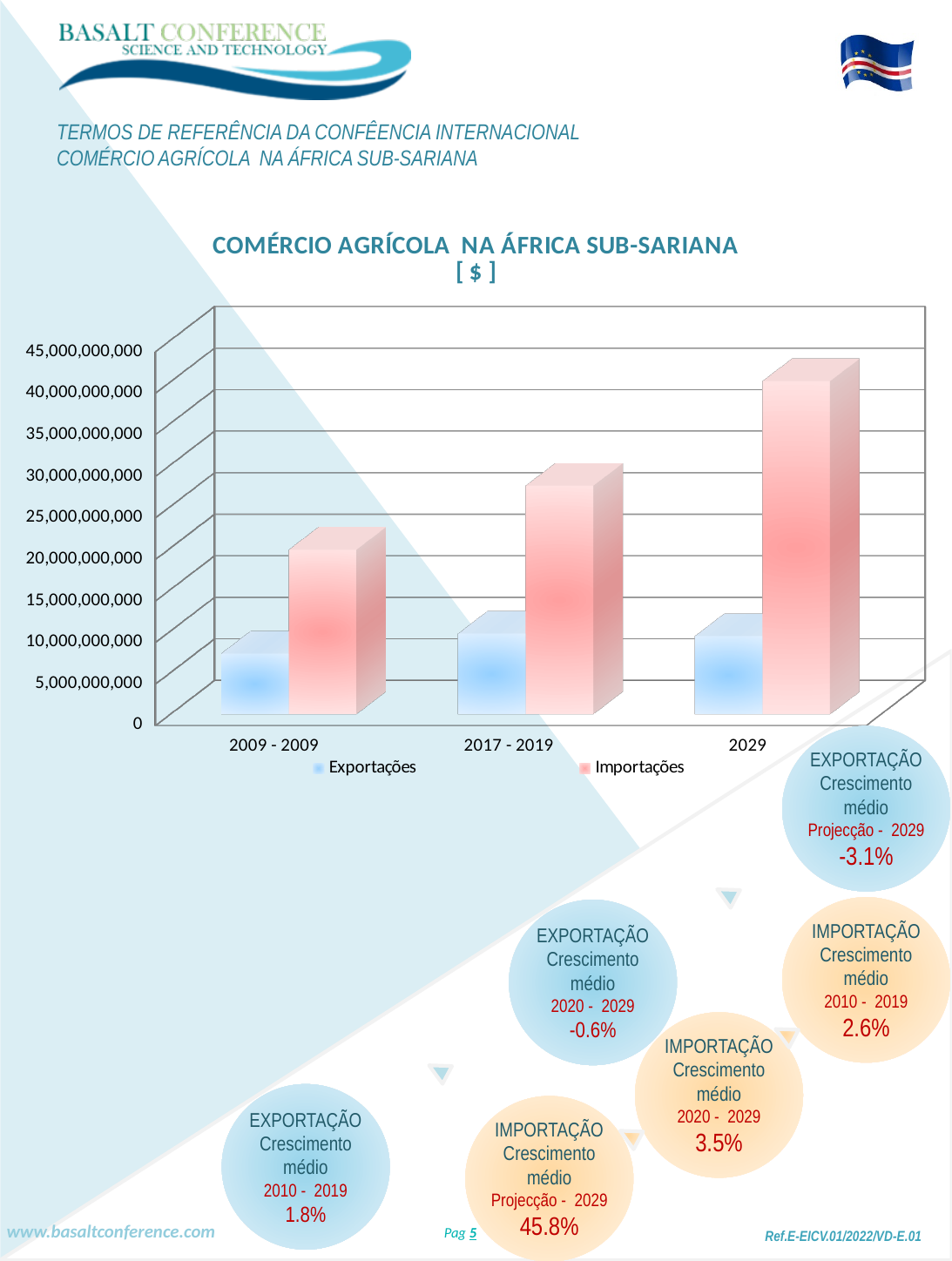
How many categories are shown on the x axis of the chart? 3 Is the Importações value for 2009 - 2009 greater or less than 25,000,000,000? less In which category is the Importações value lowest? 2009 - 2009 Which series are listed in the chart legend? Exportações and Importações What kind of chart is shown on the slide? bar chart Is the Importações value for 2029 greater or less than 35,000,000,000? greater Is the Exportações value for 2017 - 2019 greater or less than 15,000,000,000? less How many series does the chart legend list? 2 What is the title of the chart? COMÉRCIO AGRÍCOLA NA ÁFRICA SUB-SARIANA [ $ ] In which category is the Importações value highest? 2029 In 2029, which is larger, Exportações or Importações? Importações Do the Importações values rise or fall from 2009 - 2009 to 2029? rise